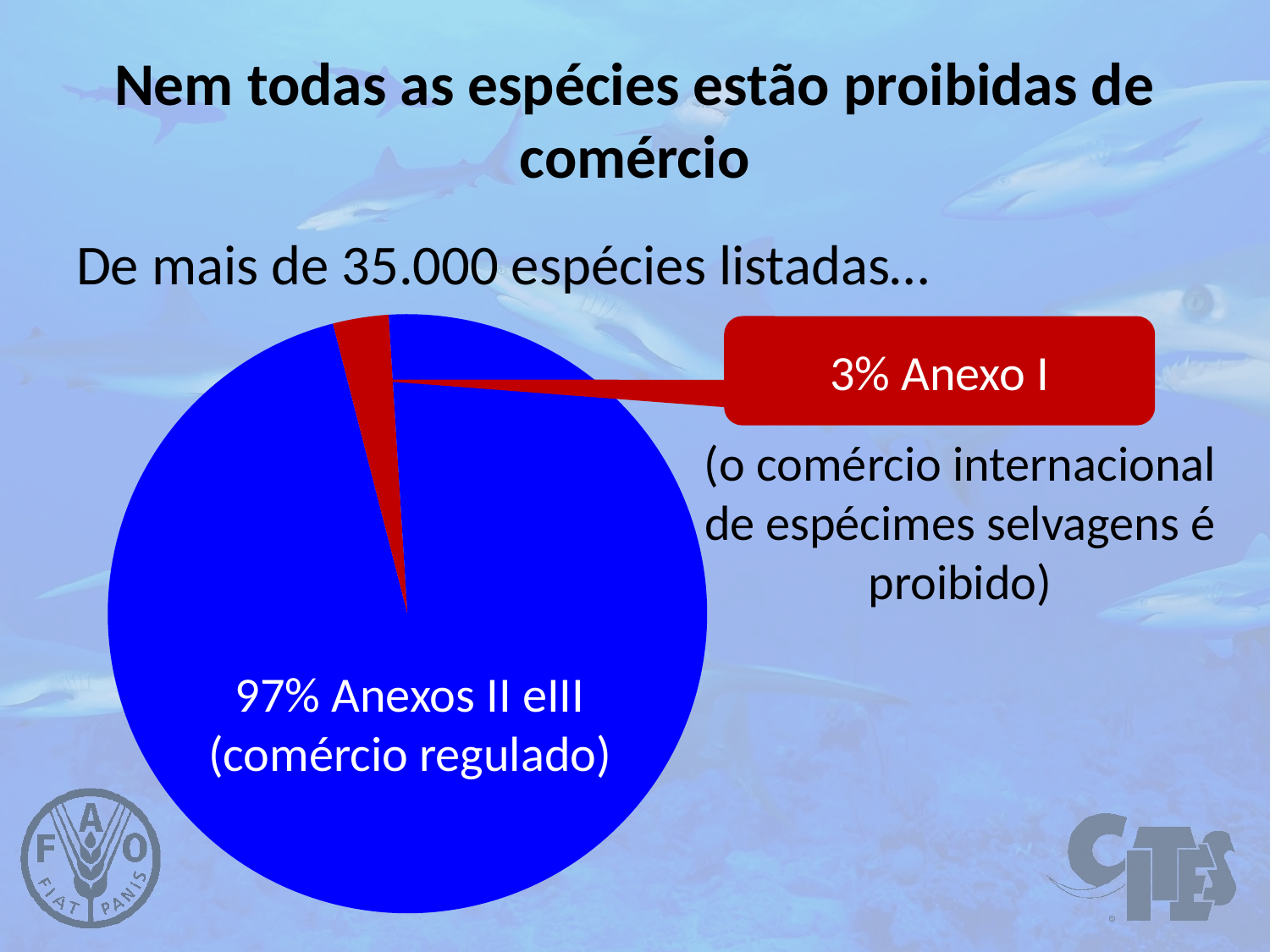
How many slices does the pie chart have? 2 Which slice of the pie is the largest? Anexos II e III What share of the pie does Anexo I represent? 3% Which is larger, the Anexo I slice or the Anexos II e III slice? Anexos II e III What colour is the Anexos II e III slice? blue What is the difference in percentage points between the Anexos II e III slice and the Anexo I slice? 94 What kind of chart is shown on the slide? pie chart Is the share for Anexo I greater or less than 50%? less What share of the pie do Anexos II e III represent? 97% Which slice of the pie is the smallest? Anexo I What colour is the Anexo I slice? red